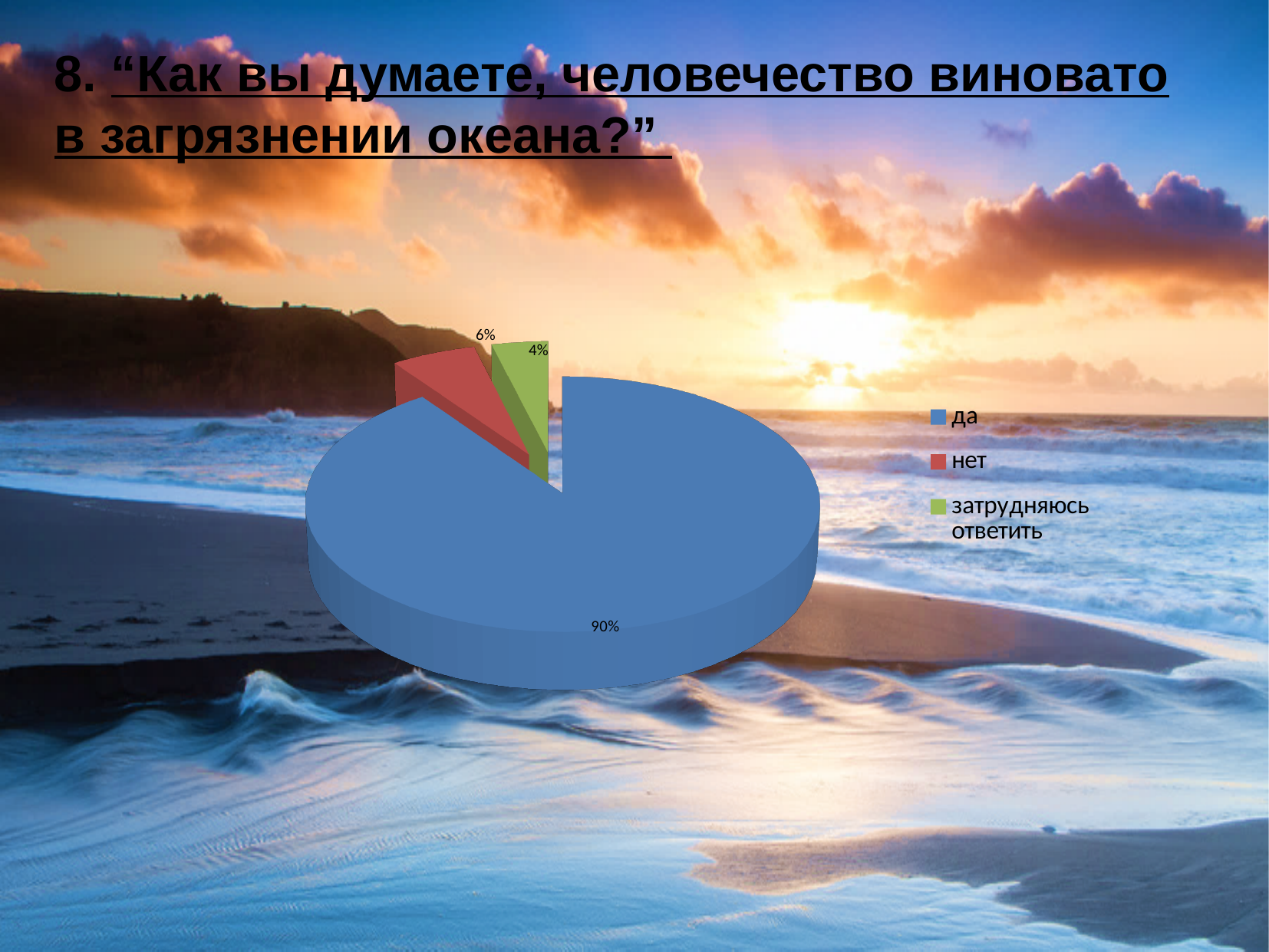
What colour is the slice for "нет"? red What is the difference in percentage points between "да" and "нет"? 84 What percentage of respondents answered "нет"? 6% What is the difference in percentage points between "нет" and "затрудняюсь ответить"? 2 What percentage of respondents answered "затрудняюсь ответить"? 4% Which is larger, the share for "нет" or the share for "затрудняюсь ответить"? нет What kind of chart is shown on the slide? pie chart What percentage of respondents answered "да"? 90% Which answer has the largest share of the pie? да How many entries does the legend list? 3 Which answer has the smallest share of the pie? затрудняюсь ответить How many slices does the pie chart have? 3